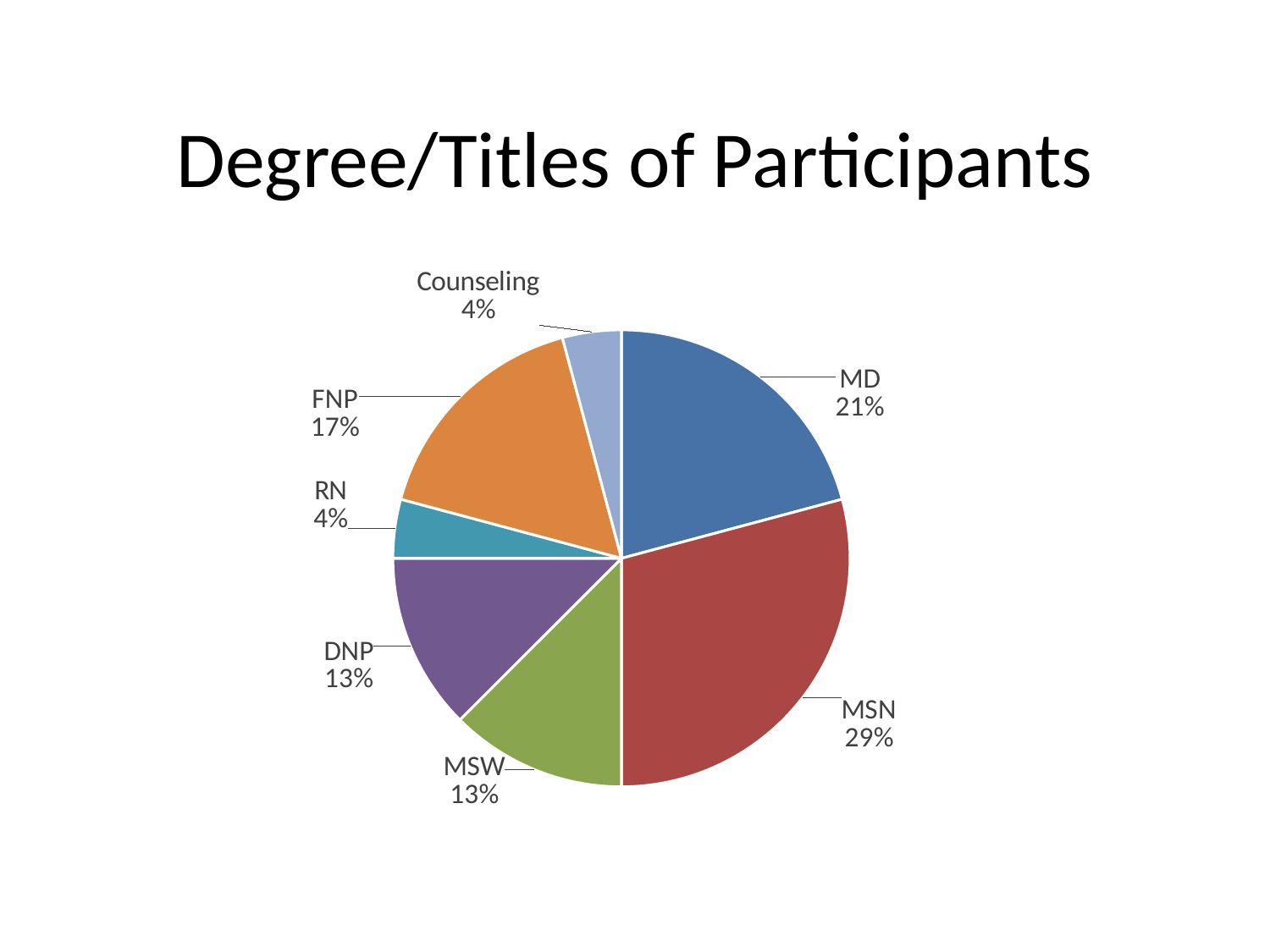
What is the difference in percentage points between the MSN and MD slices? 8 What percentage of participants are MDs? 21% Which two categories share the smallest percentage of participants? Counseling and RN What percentage of participants are RNs? 4% What share of participants hold an MSN degree? 29% Which is larger, the FNP slice or the DNP slice? FNP What percentage of participants are FNPs? 17% What kind of chart is shown on the slide? Pie chart Which degree/title has the largest share of participants? MSN What is the combined share of the MSW and DNP slices? 26% How many degree/title categories are shown in the pie chart? 7 What is the title of the chart? Degree/Titles of Participants